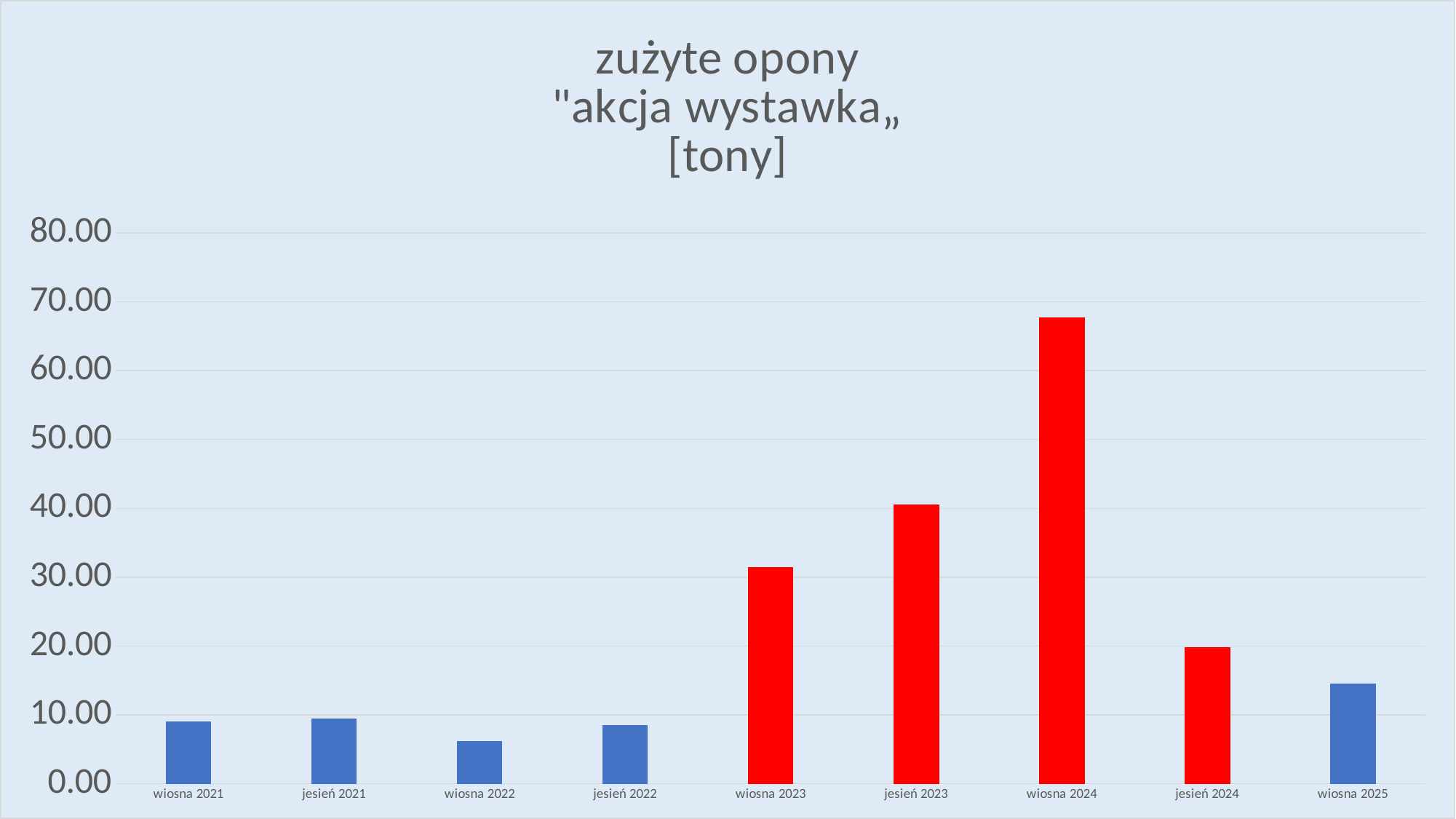
Is the value for wiosna 2023 greater or less than 40.00? less What unit is given in square brackets in the chart title? tony Which category has the highest value in the chart? wiosna 2024 Is the value for wiosna 2022 greater or less than 10.00? less Is the value for wiosna 2025 greater or less than 10.00? greater Which category has the lowest value in the chart? wiosna 2022 What kind of chart is shown on the slide? bar chart Which is larger, the value for wiosna 2023 or the value for jesień 2023? jesień 2023 Which is larger, the value for jesień 2024 or the value for wiosna 2025? jesień 2024 How many categories are shown on the x axis of the chart? 9